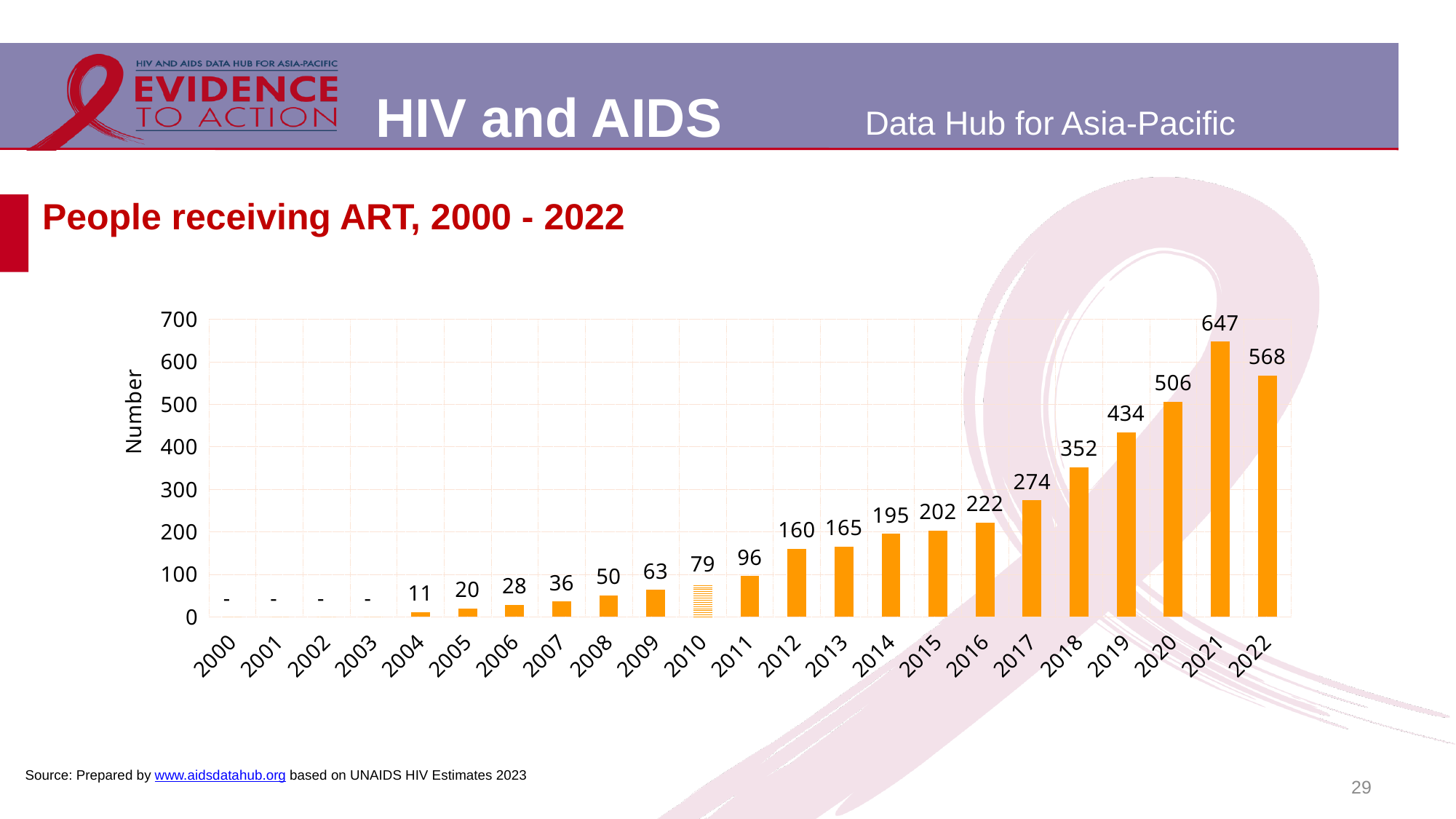
What is the number of people receiving ART in 2004? 11 What is the number of people receiving ART in 2021? 647 Which year has the larger value, 2020 or 2022? 2022 Do the values generally rise or fall from 2004 to 2021? Rise Is the value for 2017 greater or less than 300? less What is the difference between the values for 2021 and 2022? 79 What is the label of the y axis? Number How many years are shown on the x axis? 23 What is the number of people receiving ART in 2010? 79 Which year has the highest number of people receiving ART? 2021 What is the difference between the values for 2019 and 2018? 82 What kind of chart is shown on the slide? Bar chart